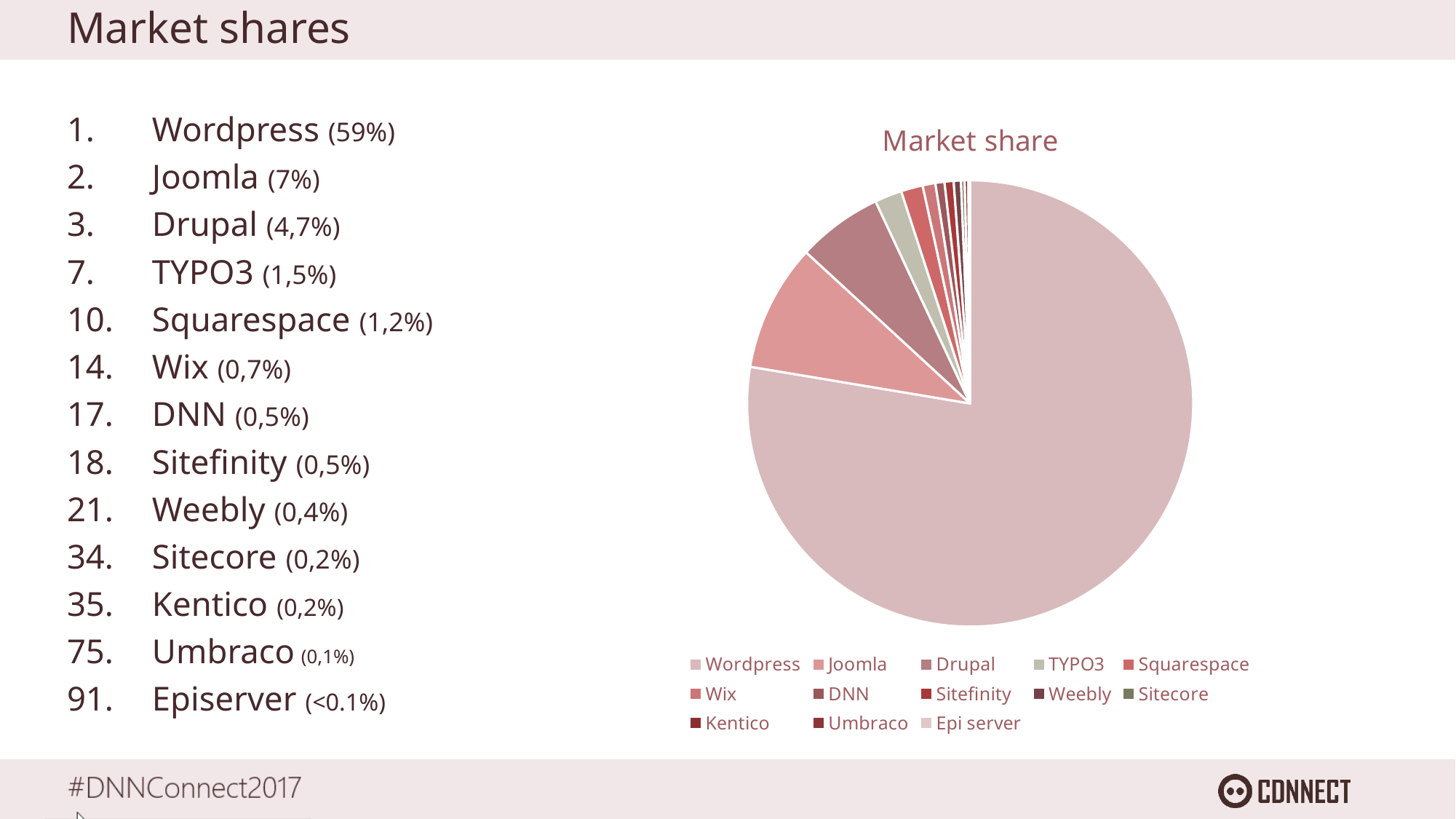
How many categories does the legend of the pie chart list? 13 What is the market share of Joomla? 7% What is the market share of DNN? 0,5% Which has the larger slice, Joomla or Drupal? Joomla Which has the larger market share, TYPO3 or Squarespace? TYPO3 What is the difference between the market shares of Wordpress and Joomla? 52% What is the market share of Wordpress? 59% What is the market share of Drupal? 4,7% What is the title of the chart? Market share Which category has the largest slice of the pie chart? Wordpress What kind of chart is shown on the slide? pie chart